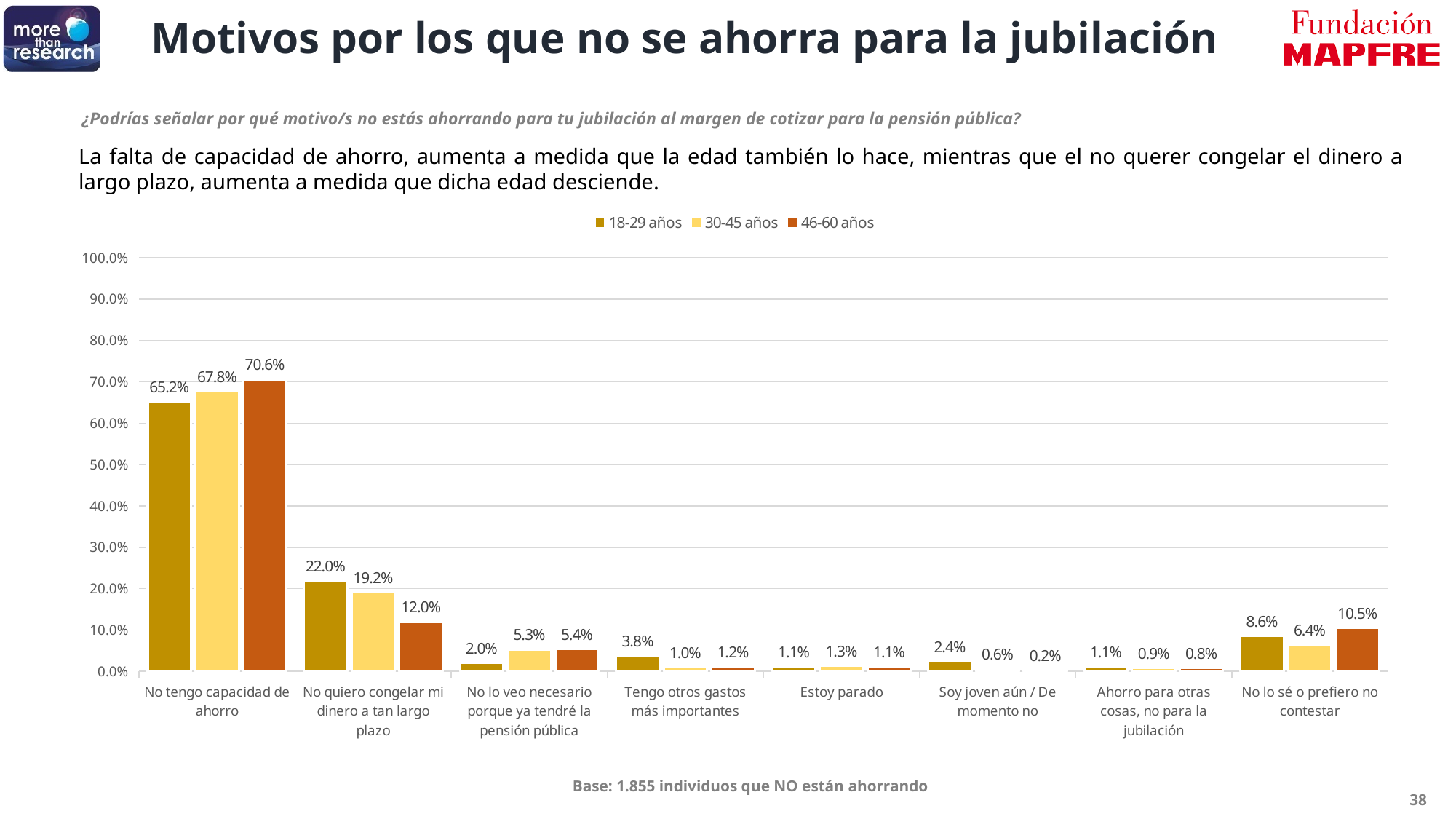
In the 'Tengo otros gastos más importantes' category, which series has the larger value: 18-29 años or 30-45 años? 18-29 años What is the value for the 46-60 años series in the 'No tengo capacidad de ahorro' category? 70.6% What kind of chart is shown on the slide? Bar chart What is the value for the 30-45 años series in the 'No lo sé o prefiero no contestar' category? 6.4% How many series does the legend list? 3 Which category has the lowest value for the 46-60 años series? Soy joven aún / De momento no Which category has the highest value for the 18-29 años series? No tengo capacidad de ahorro Is the value for 30-45 años in the 'No tengo capacidad de ahorro' category greater or less than 60.0%? greater What is the difference between the 18-29 años and 46-60 años values in the 'No quiero congelar mi dinero a tan largo plazo' category? 10.0% What is the value for the 18-29 años series in the 'No quiero congelar mi dinero a tan largo plazo' category? 22.0% What is the difference between the 46-60 años and 18-29 años values in the 'No tengo capacidad de ahorro' category? 5.4% How many categories are shown on the x axis of the chart? 8